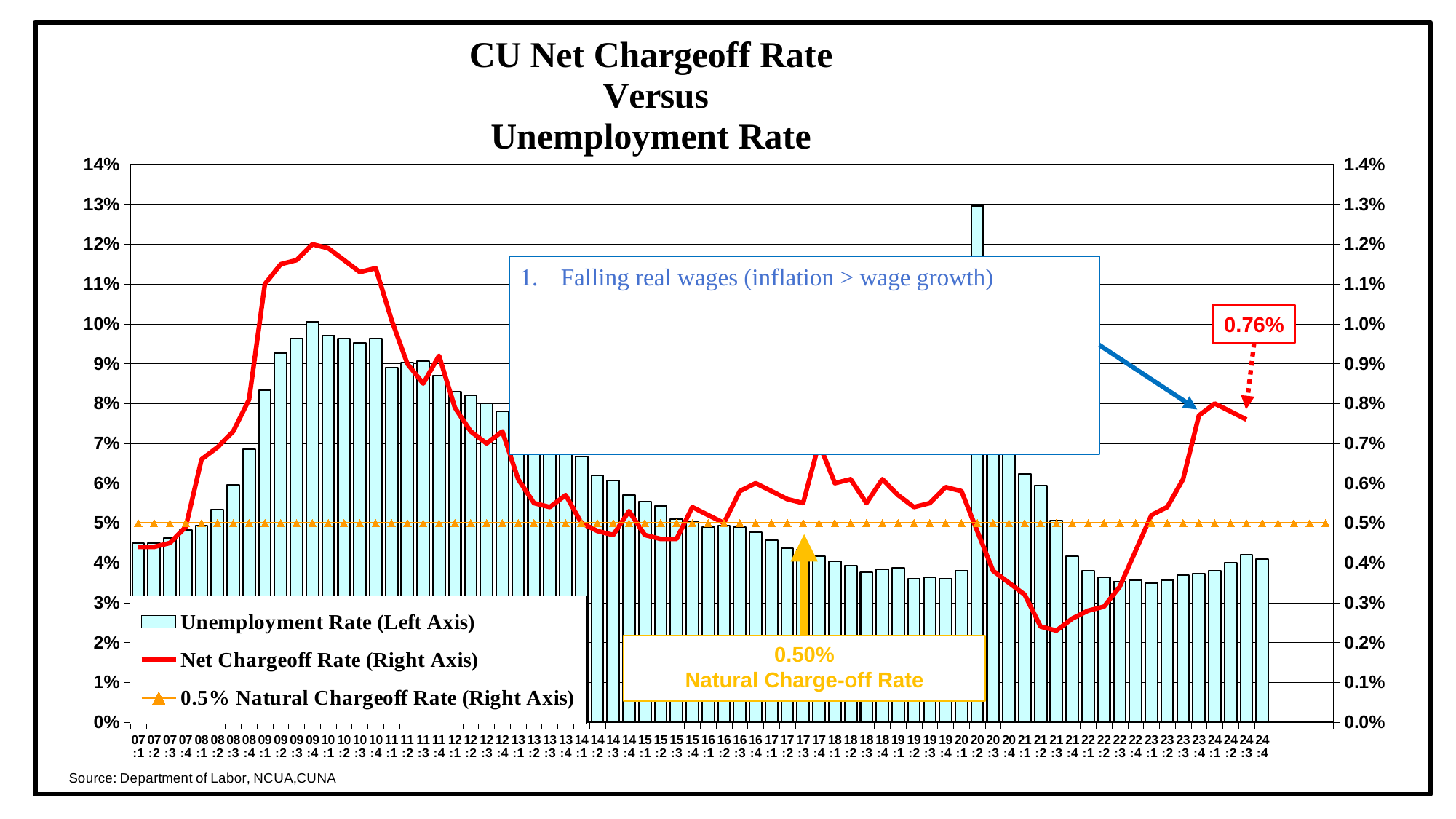
Is the Net Chargeoff Rate for 21:3 greater or less than 0.3%? less In which quarter is the Unemployment Rate highest? 20:2 What is the title of the chart? CU Net Chargeoff Rate Versus Unemployment Rate What value is given for the Natural Charge-off Rate? 0.50% Is the Net Chargeoff Rate at 24:4 (0.76%) above or below the 0.50% Natural Charge-off Rate? above Does the Net Chargeoff Rate rise or fall from 22:3 to 24:1? rise Is the Net Chargeoff Rate for 09:4 greater or less than 1.1%? greater How many series does the legend list? 3 What kind of chart is this? Combination bar and line chart What is the Net Chargeoff Rate value labeled at the end of the series (24:4)? 0.76% Is the Unemployment Rate for 20:2 greater or less than 12%? greater Which is larger, the Unemployment Rate in 20:2 or in 09:4? 20:2